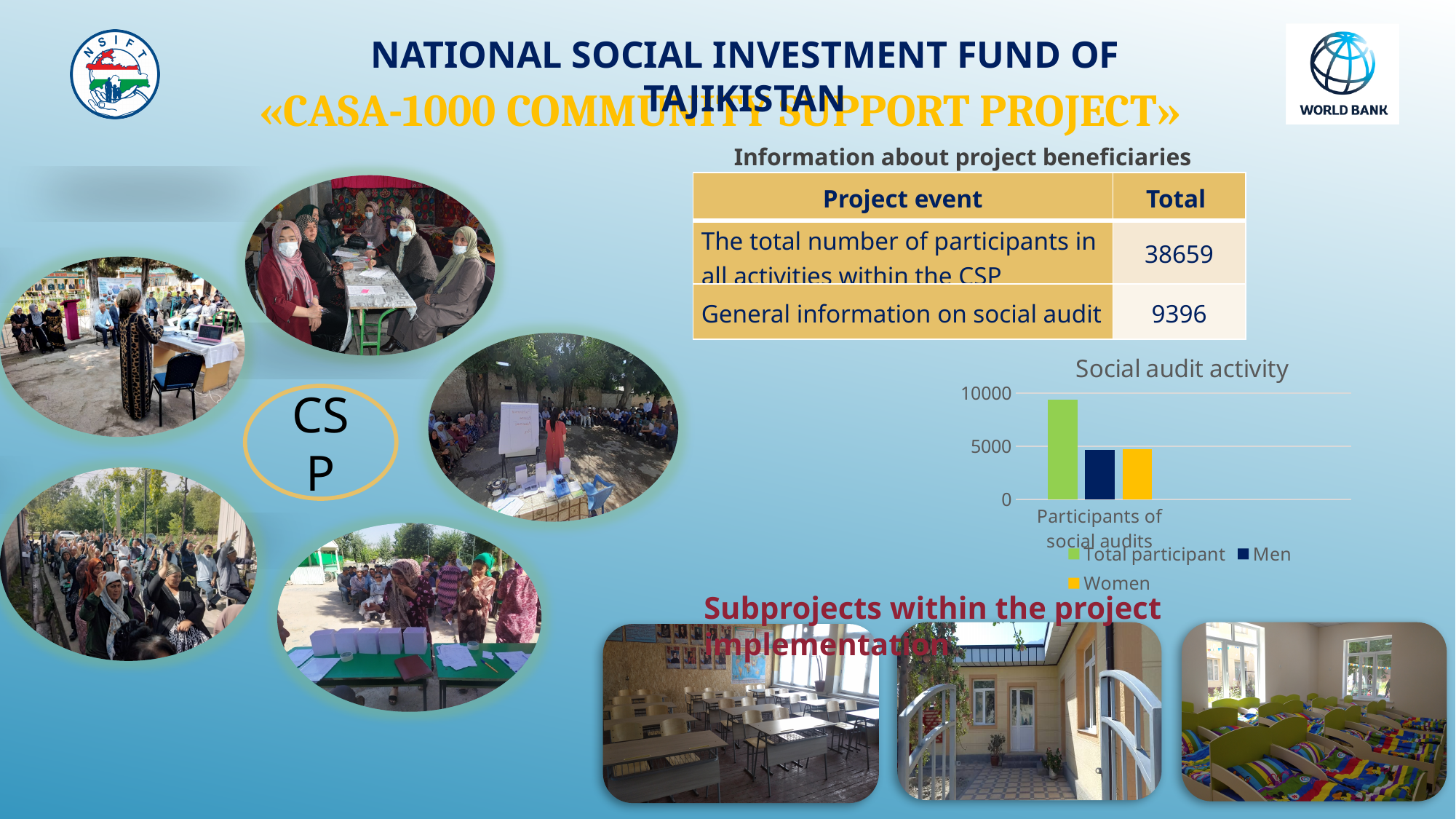
What colour is the Women series in the "Social audit activity" chart? yellow What is the title of the chart on the slide? Social audit activity In the "Social audit activity" chart, which is larger, the bar for Total participant or the bar for Men? Total participant How many series does the legend of the "Social audit activity" chart list? 3 Which series has the tallest bar in the "Social audit activity" chart? Total participant How many categories are shown on the x axis of the "Social audit activity" chart? 1 In the "Social audit activity" chart, is the value for Total participant greater or less than 10000? less What is the category label on the x axis of the "Social audit activity" chart? Participants of social audits In the "Social audit activity" chart, is the value for Women greater or less than 5000? less What kind of chart is the "Social audit activity" chart? bar chart In the "Social audit activity" chart, is the value for Men greater or less than 5000? less